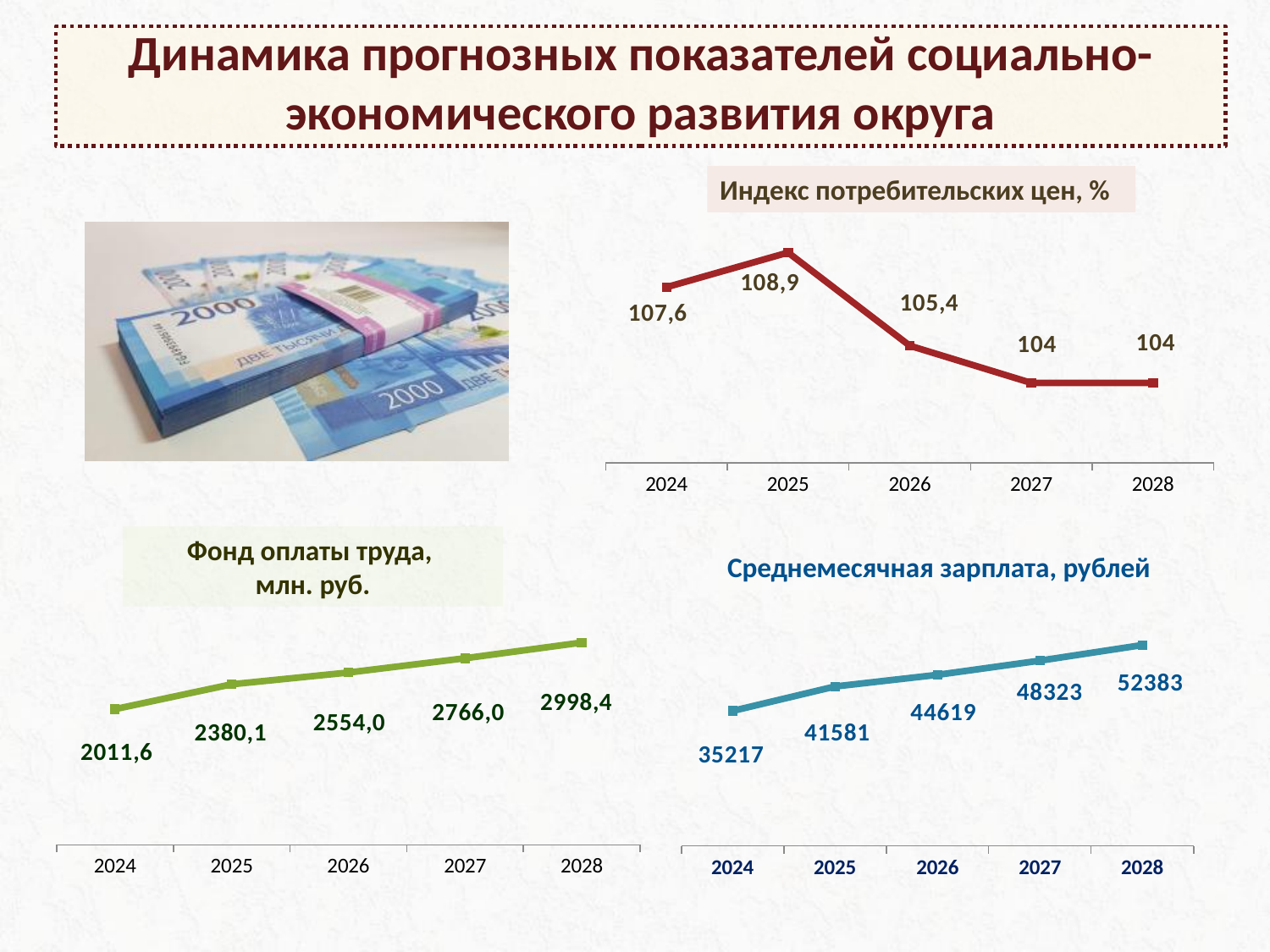
In the chart 'Среднемесячная зарплата, рублей', what is the difference between the 2028 and 2024 values? 17166 In the chart 'Среднемесячная зарплата, рублей', which is larger: the value for 2025 or the value for 2026? 2026 In the chart 'Индекс потребительских цен, %', what is the value for 2025? 108,9 In the chart 'Индекс потребительских цен, %', what is the difference between the 2025 and 2026 values? 3,5 In the chart 'Индекс потребительских цен, %', which year has the highest value? 2025 In the chart 'Фонд оплаты труда, млн. руб.', what is the difference between the 2028 and 2027 values? 232,4 What type of chart is 'Среднемесячная зарплата, рублей'? line chart In the chart 'Фонд оплаты труда, млн. руб.', which year has the lowest value? 2024 In the chart 'Среднемесячная зарплата, рублей', what is the value for 2027? 48323 In the chart 'Фонд оплаты труда, млн. руб.', what is the value for 2024? 2011,6 In the chart 'Индекс потребительских цен, %', how many years are plotted? 5 In the chart 'Фонд оплаты труда, млн. руб.', do the values rise or fall from 2024 to 2028? rise